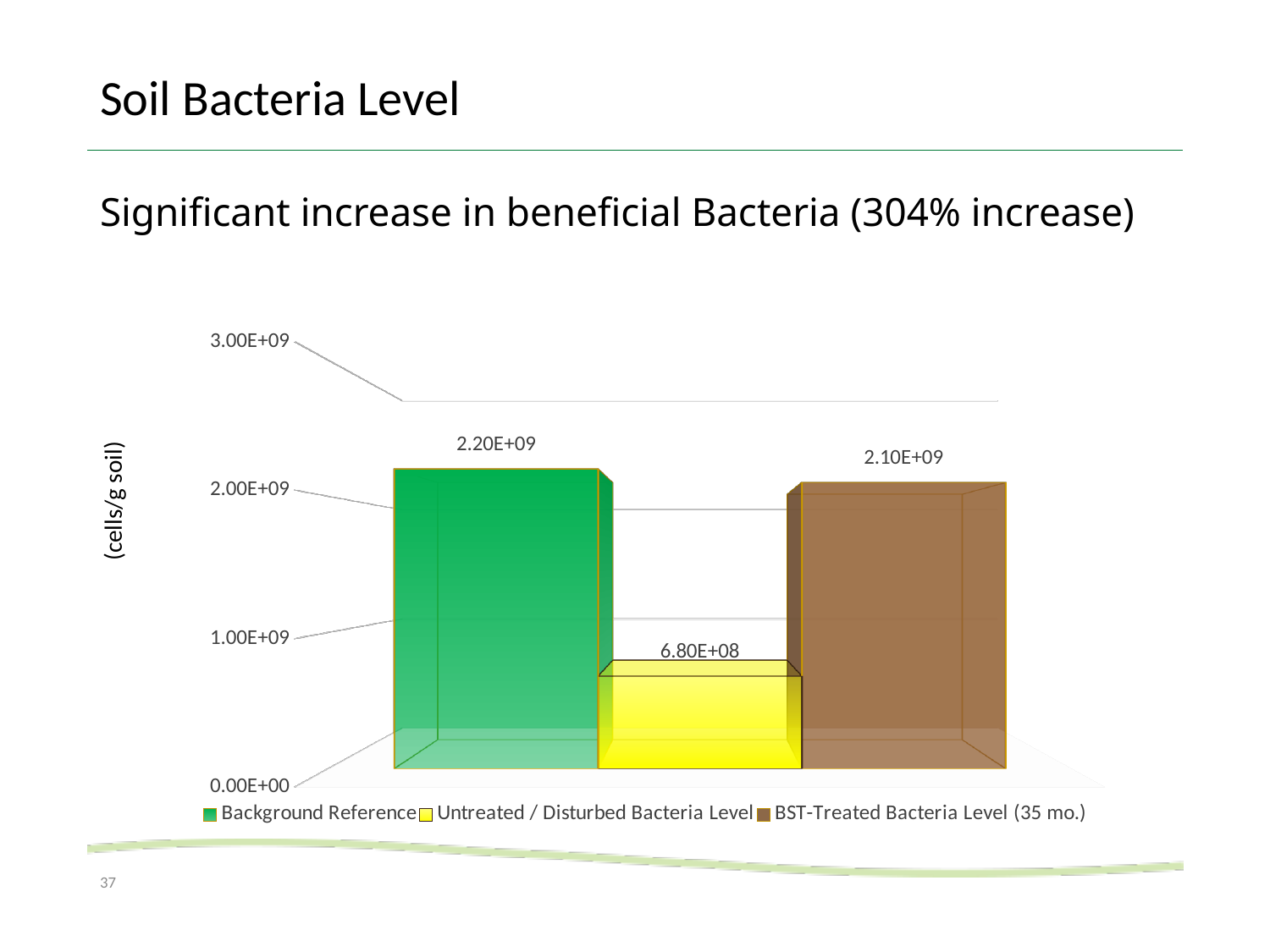
What is the value for Background Reference? 2.20E+09 What colour is the bar for BST-Treated Bacteria Level (35 mo.)? brown Which is larger, the Untreated / Disturbed Bacteria Level or the BST-Treated Bacteria Level (35 mo.)? BST-Treated Bacteria Level (35 mo.) How many series does the legend list? 3 Which series has the lowest value? Untreated / Disturbed Bacteria Level What is the value for Untreated / Disturbed Bacteria Level? 6.80E+08 Is the value for Untreated / Disturbed Bacteria Level greater or less than 1.00E+09? less What unit is shown on the vertical axis label? (cells/g soil) What kind of chart is shown on the slide? bar chart What is the value for BST-Treated Bacteria Level (35 mo.)? 2.10E+09 Which series has the highest value? Background Reference Is the value for BST-Treated Bacteria Level (35 mo.) greater or less than 2.00E+09? greater